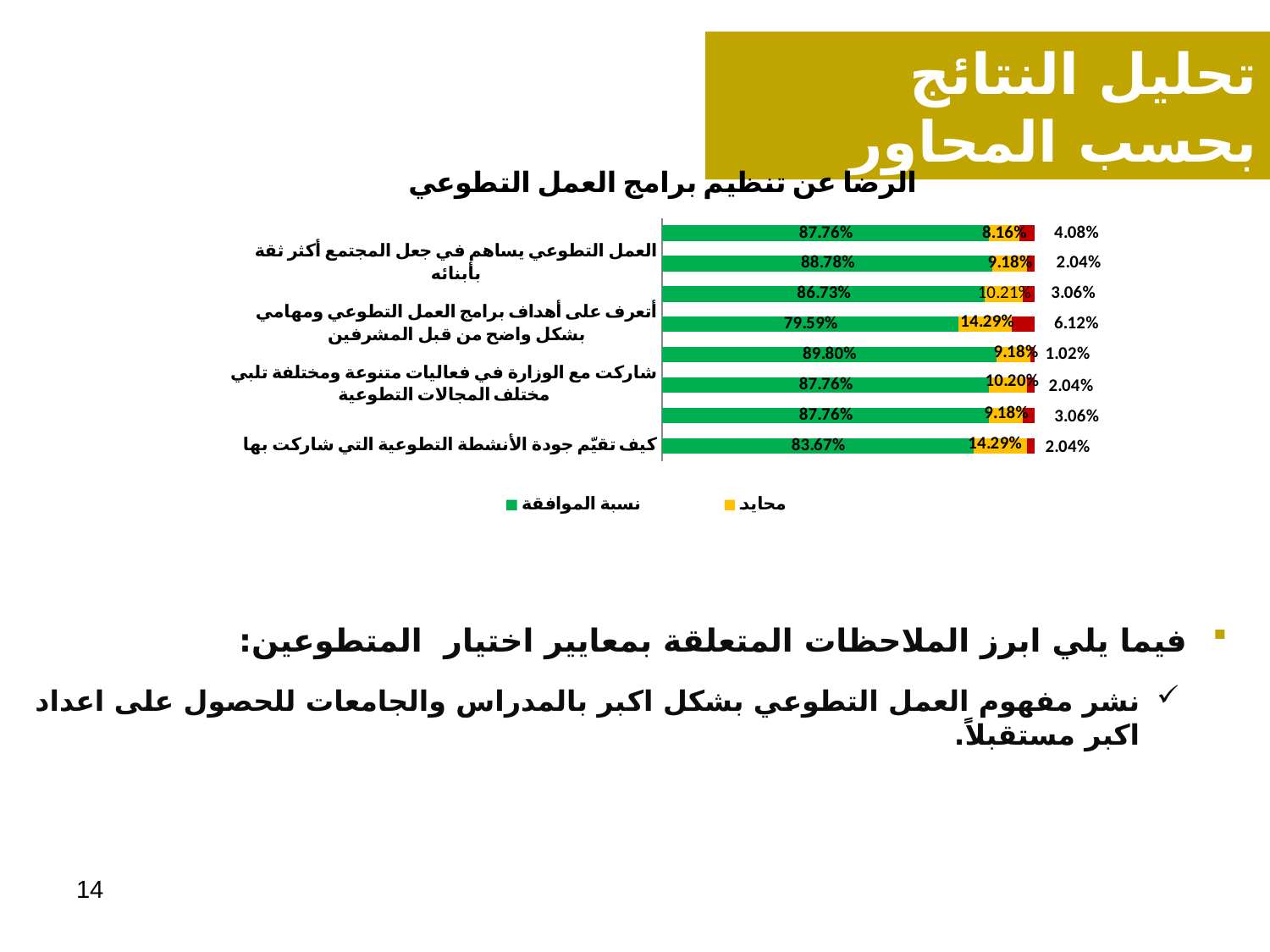
Which is larger: the نسبة الموافقة value of the top bar (87.76%) or of the bottom bar (83.67%)? the top bar (87.76%) Which two series are listed in the chart legend? نسبة الموافقة and محايد What is the lowest نسبة الموافقة (green) value shown in the chart? 79.59% How many bars are plotted in the chart? 8 What is the highest نسبة الموافقة (green) value shown in the chart? 89.80% What is the smallest value shown for the red (rightmost) segment across all bars? 1.02% What is the محايد value for the category 'كيف تقيّم جودة الأنشطة التطوعية التي شاركت بها'? 14.29% What type of chart is shown on the slide? bar chart What is the title of the chart? الرضا عن تنظيم برامج العمل التطوعي What is the نسبة الموافقة value for the category 'أتعرف على أهداف برامج العمل التطوعي ومهامي بشكل واضح من قبل المشرفين'? 79.59% What is the نسبة الموافقة value for the category 'كيف تقيّم جودة الأنشطة التطوعية التي شاركت بها'? 83.67% What is the largest value shown for the red (rightmost) segment across all bars? 6.12%